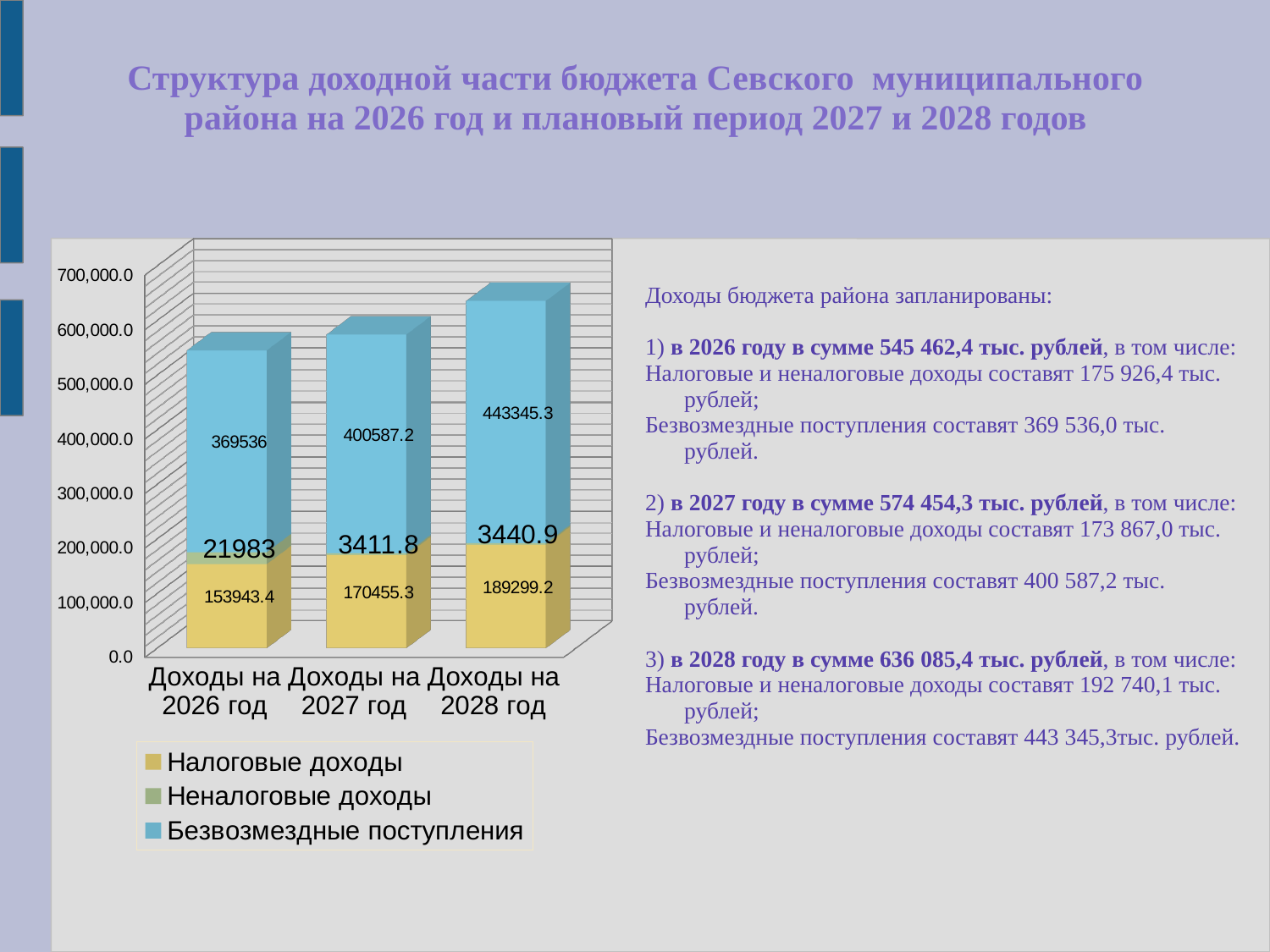
What is the total of the stacked bar for Доходы на 2026 год? 545462.4 What is the value of Безвозмездные поступления for Доходы на 2027 год? 400587.2 Which year has the lowest value of Неналоговые доходы? Доходы на 2027 год How many categories (years) are shown on the x axis of the chart? 3 How many series does the chart legend list? 3 What is the difference between Налоговые доходы for 2028 and for 2026? 35355.8 What is the value of Неналоговые доходы for Доходы на 2026 год? 21983 Which is larger: Безвозмездные поступления for 2026 or Налоговые доходы for 2027? Безвозмездные поступления for 2026 Do the total bar heights rise or fall from 2026 to 2028? Rise What type of chart is shown on the slide? Stacked bar chart Which year has the highest value of Безвозмездные поступления? Доходы на 2028 год What is the value of Налоговые доходы for Доходы на 2028 год? 189299.2